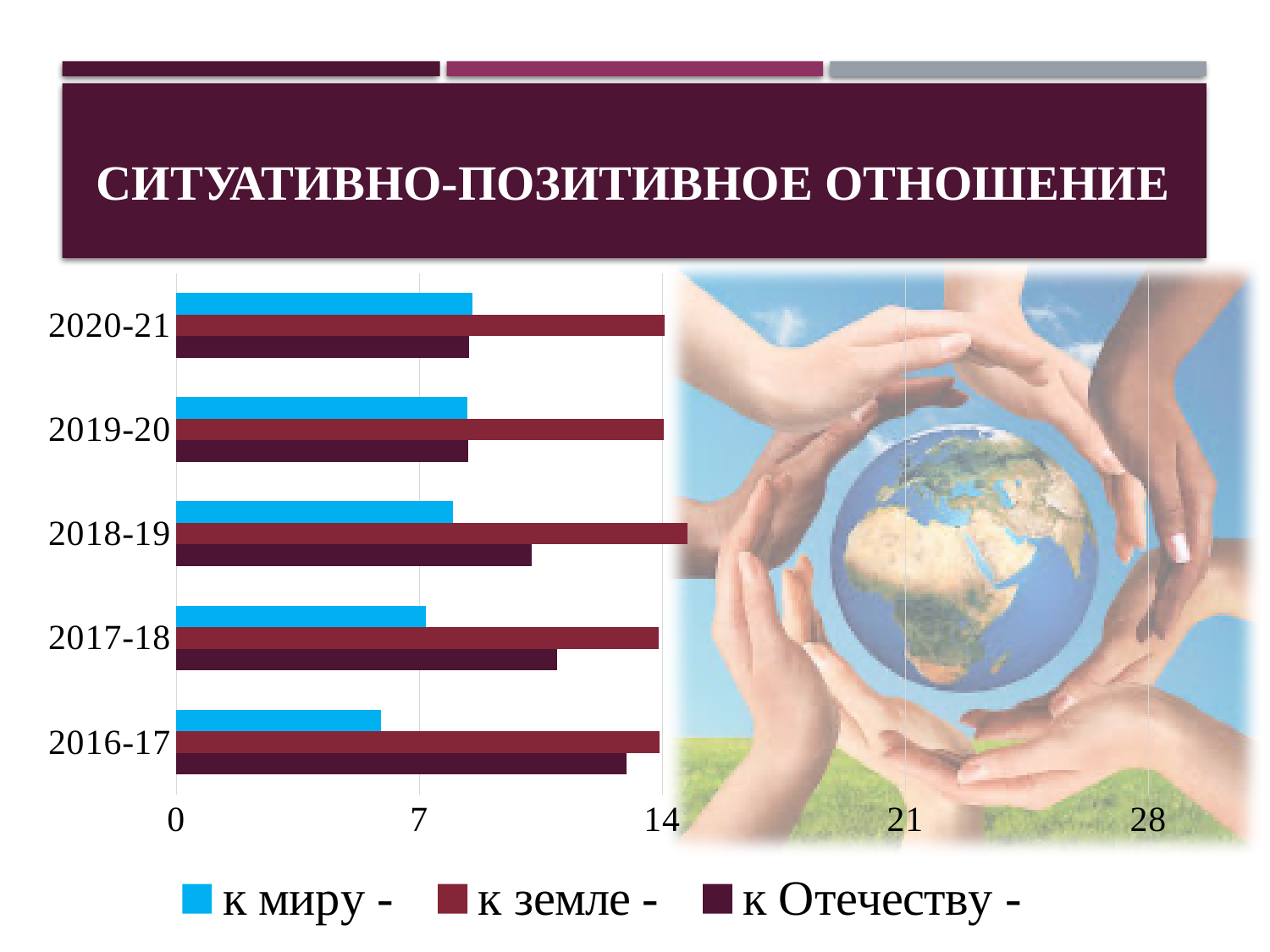
Is the value for к Отечеству in 2017-18 greater or less than 7? greater How many series does the chart legend list? 3 Which year has the lowest value for к миру? 2016-17 Is the value for к земле in 2018-19 greater or less than 14? greater Is the value for к Отечеству in 2016-17 greater or less than 14? less What is the title of the slide containing the chart? СИТУАТИВНО-ПОЗИТИВНОЕ ОТНОШЕНИЕ Which year has the highest value for к Отечеству? 2016-17 What kind of chart is shown on the slide? bar chart In 2018-19, which is larger: к земле or к Отечеству? к земле How many year categories are shown on the chart? 5 In 2016-17, which is larger: к миру or к земле? к земле